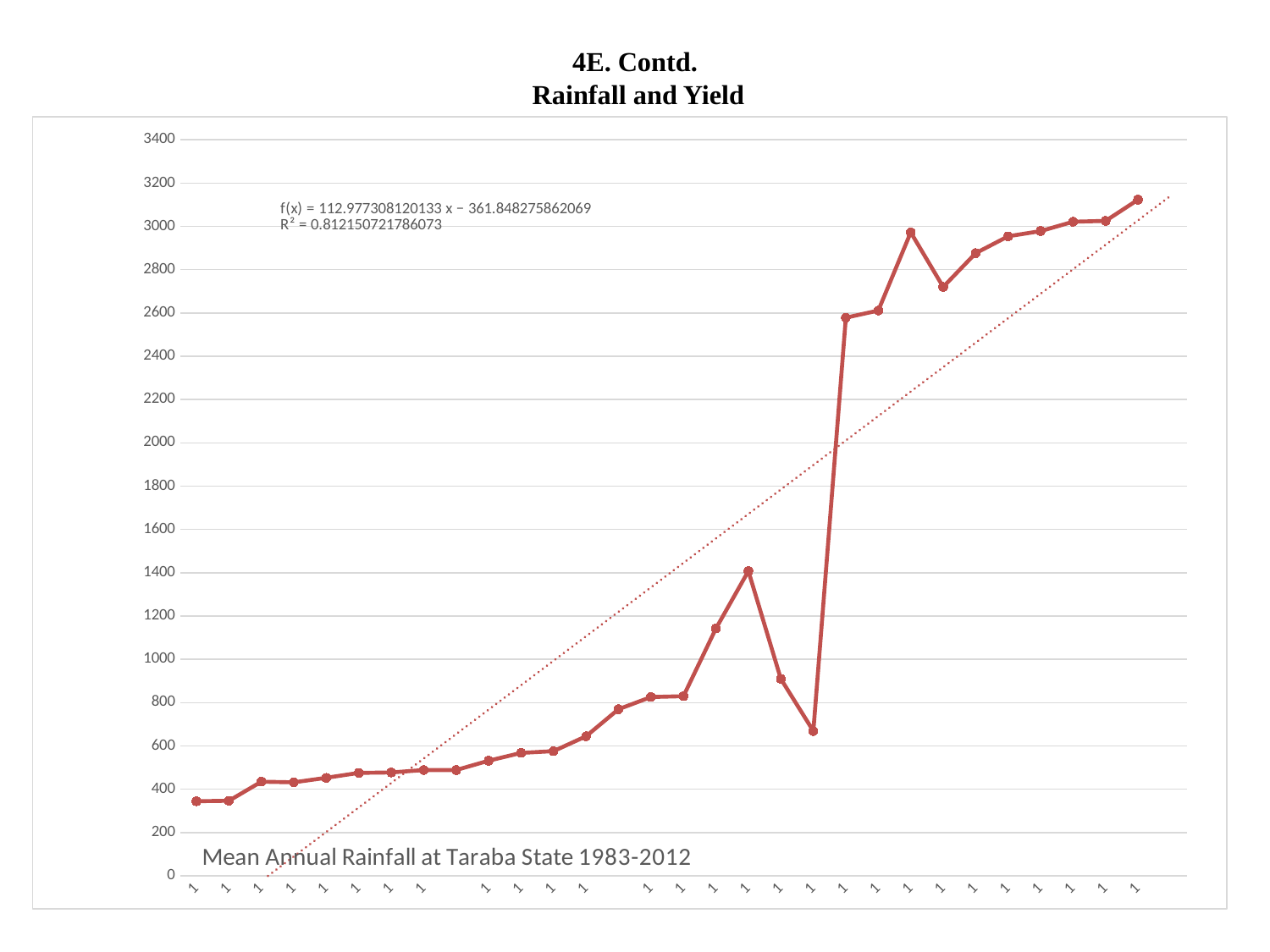
What R² value is printed on the chart for the trendline? 0.812150721786073 What is the title of the chart? Mean Annual Rainfall at Taraba State 1983-2012 Is the value of the last (rightmost) point greater or less than 3000? greater How many data points are plotted on the line? 30 Do the plotted values generally rise or fall from left to right along the x axis? rise Is the highest value plotted on the chart greater or less than 3000? greater Is the value of the first (leftmost) point greater or less than 400? less Is the value of the last point greater or less than the value of the first point? greater What kind of chart is shown on the slide? line chart